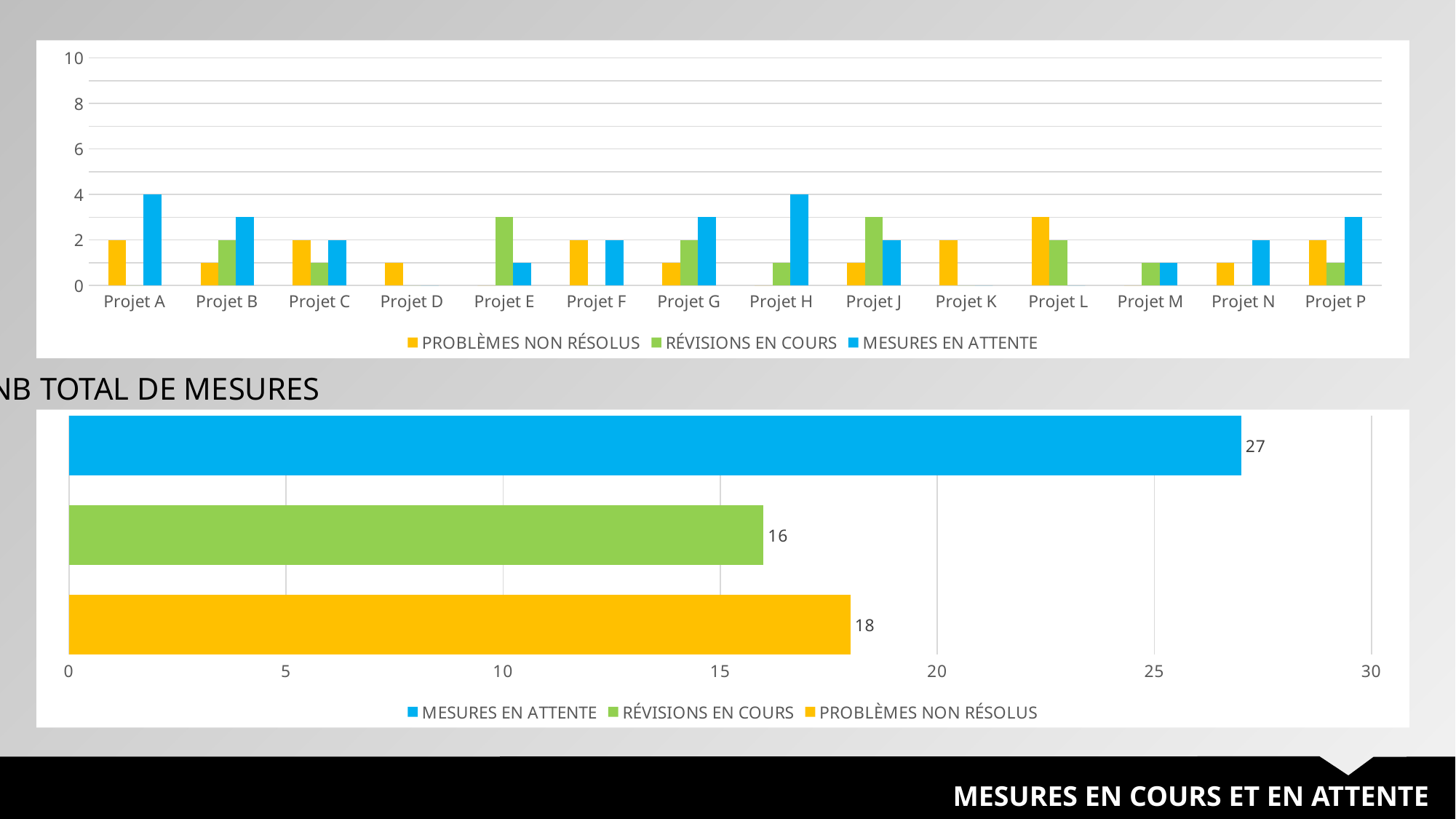
In the bottom chart (NB TOTAL DE MESURES), which is larger: PROBLÈMES NON RÉSOLUS or RÉVISIONS EN COURS? PROBLÈMES NON RÉSOLUS In the top chart, what is the value of PROBLÈMES NON RÉSOLUS for Projet K? 2 In the top chart, how many projects are shown on the x axis? 14 In the top chart, is the value of RÉVISIONS EN COURS for Projet E greater or less than 2? greater In the bottom chart (NB TOTAL DE MESURES), what is the value for RÉVISIONS EN COURS? 16 In the top chart, what is the value of MESURES EN ATTENTE for Projet A? 4 In the top chart, how many series does the legend list? 3 In the bottom chart (NB TOTAL DE MESURES), what is the difference between MESURES EN ATTENTE and PROBLÈMES NON RÉSOLUS? 9 What kind of chart is the top chart? Bar chart In the bottom chart (NB TOTAL DE MESURES), which category has the highest value? MESURES EN ATTENTE In the bottom chart (NB TOTAL DE MESURES), what is the value for MESURES EN ATTENTE? 27 In the bottom chart (NB TOTAL DE MESURES), which category has the lowest value? RÉVISIONS EN COURS